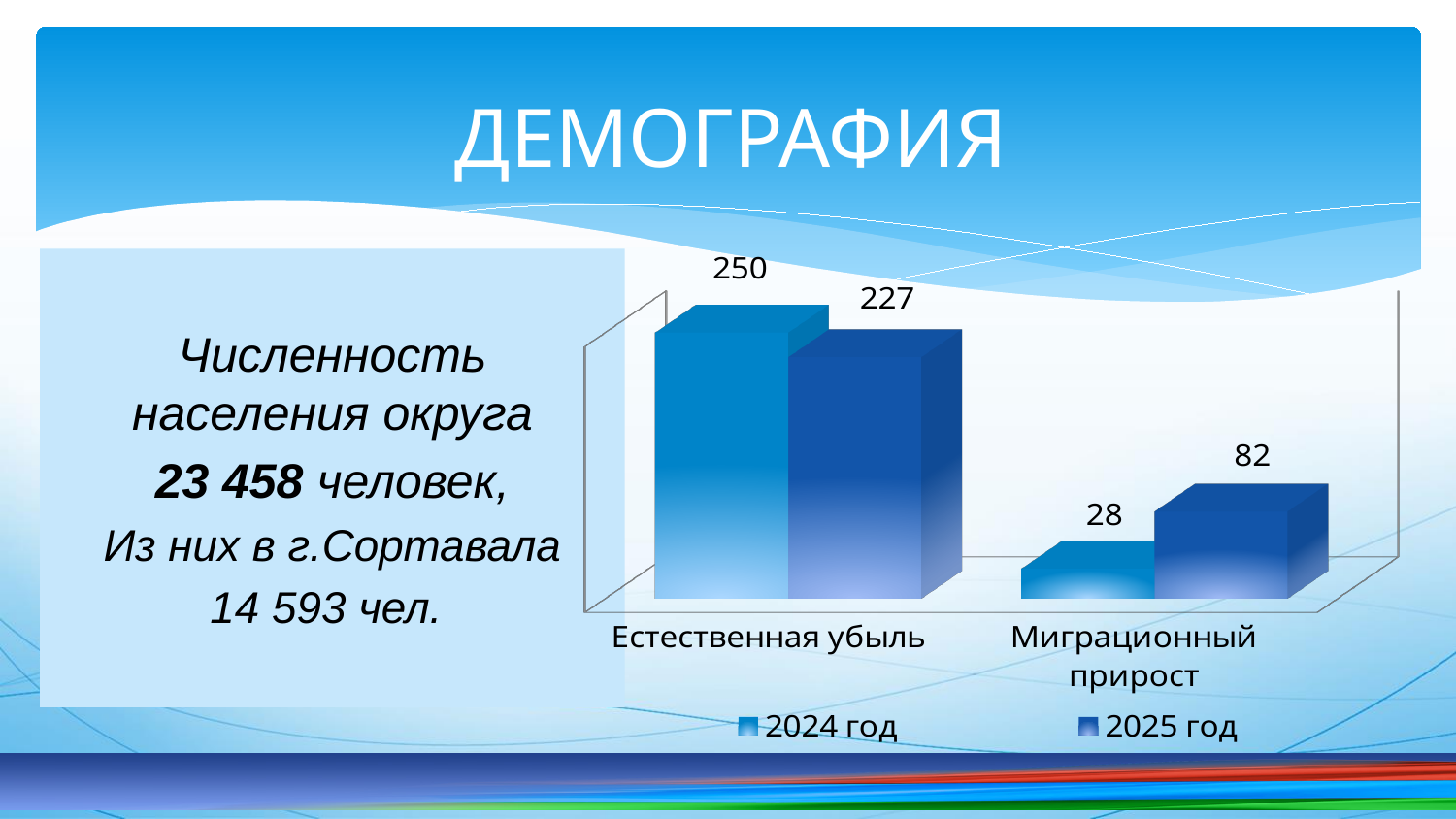
What is the value for Миграционный прирост in 2025 год? 82 What kind of chart is shown on the slide? Bar chart How many series does the chart legend list? 2 Which category has the lowest value in the 2025 год series? Миграционный прирост What is the difference between the 2024 год and 2025 год values for Естественная убыль? 23 What is the value for Естественная убыль in 2024 год? 250 How many categories are shown on the x axis of the chart? 2 What is the value for Миграционный прирост in 2024 год? 28 What is the value for Естественная убыль in 2025 год? 227 What is the difference between the 2025 год and 2024 год values for Миграционный прирост? 54 Which is larger for Миграционный прирост: the 2024 год value or the 2025 год value? 2025 год Which category has the highest value in the 2024 год series? Естественная убыль